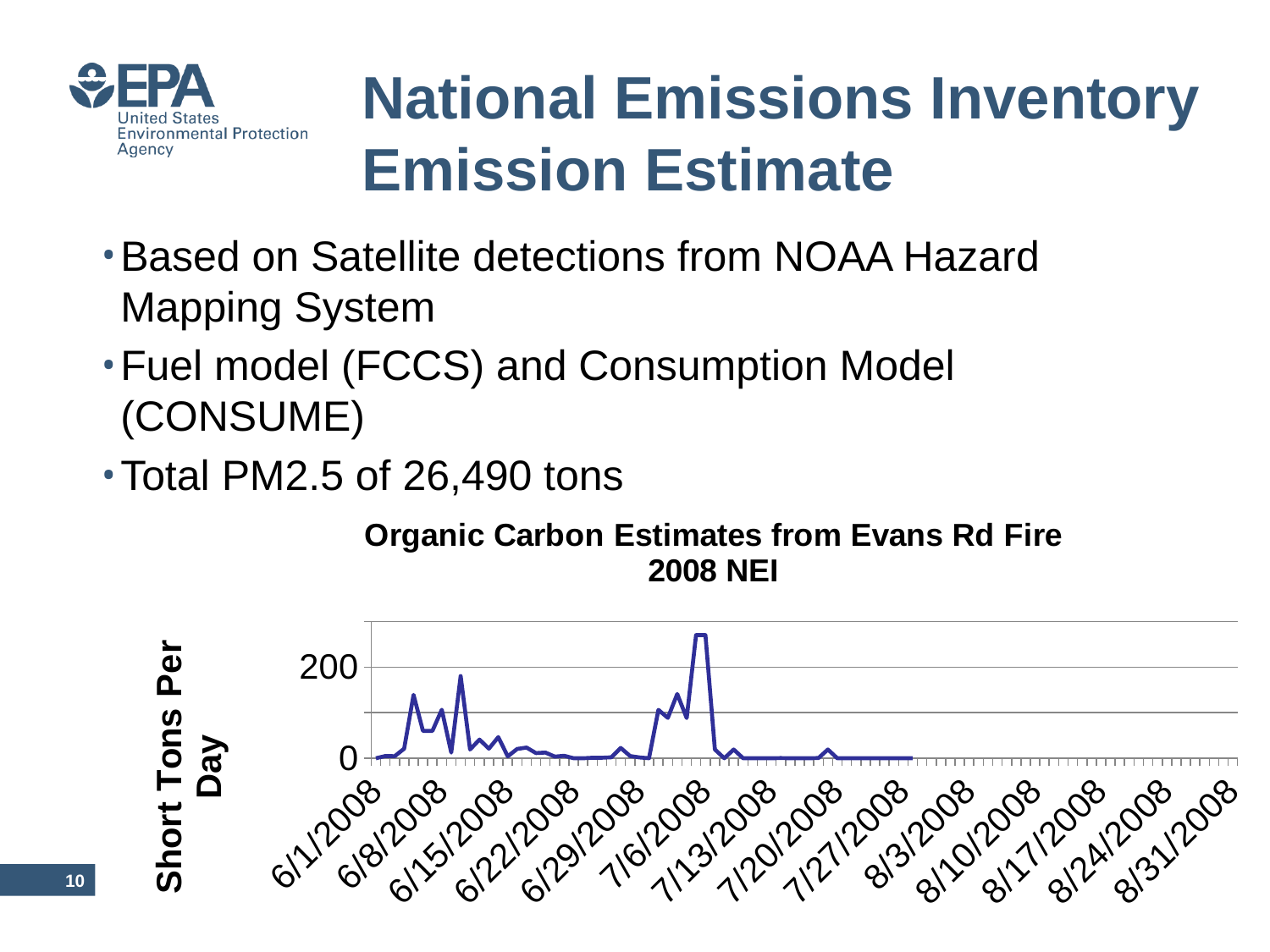
What is the label on the vertical axis of the chart? Short Tons Per Day In which month does the highest value on the chart occur? July What is the title of the chart? Organic Carbon Estimates from Evans Rd Fire 2008 NEI Which is larger: the peak in early July or the peak in mid-June? the peak in early July What kind of chart is shown on the slide? line chart How many date labels are shown on the horizontal axis? 14 What is the last date label on the horizontal axis? 8/31/2008 Is the value on 6/1/2008 greater or less than 200? less What is the first date label on the horizontal axis? 6/1/2008 Is the peak value in mid-June (around 6/15/2008) greater or less than 200? less After the early-July peak, do the values rise or fall toward 7/13/2008? fall Is the highest value on the chart, reached in early July, greater or less than 200? greater